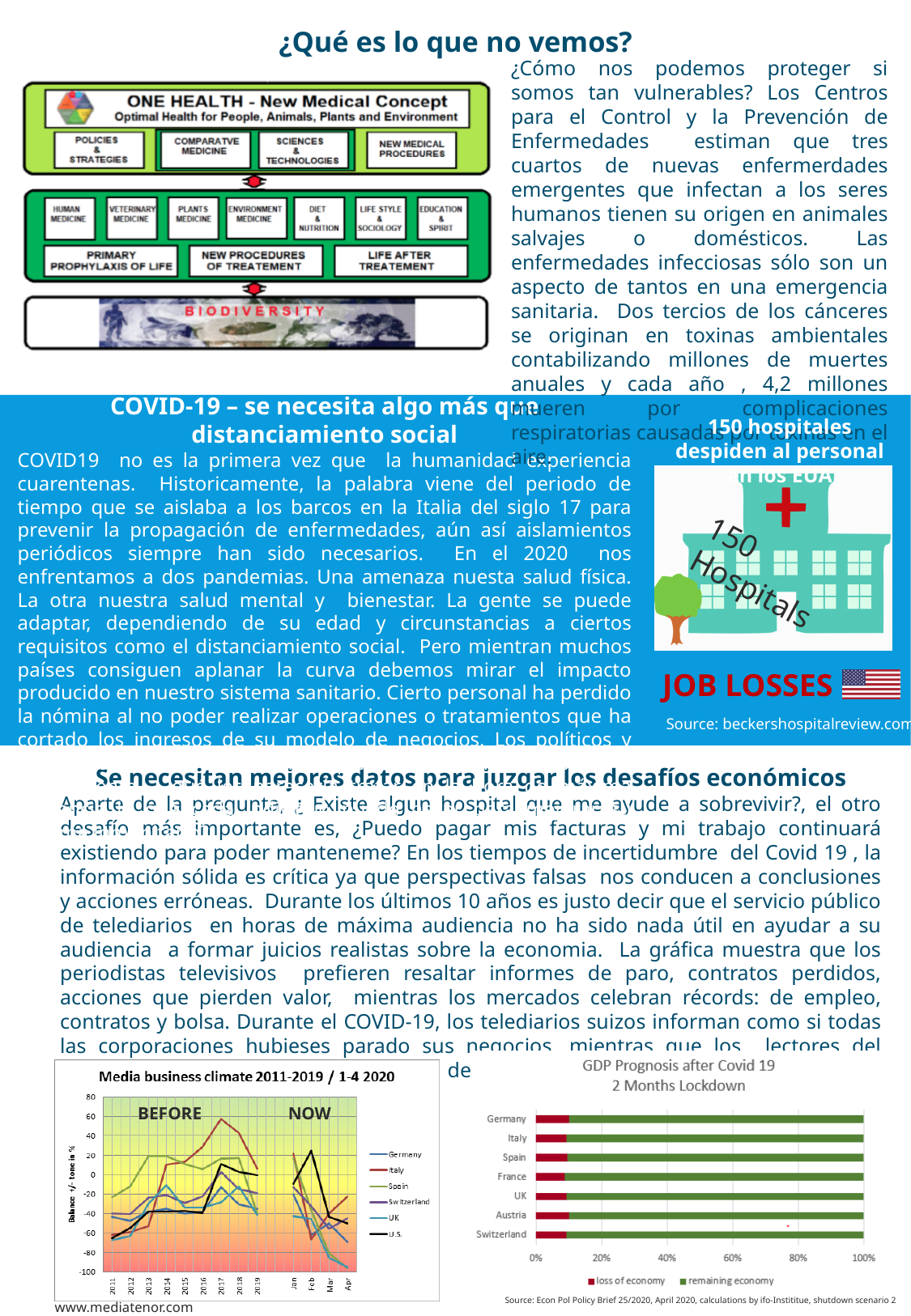
In the 'GDP Prognosis after Covid 19 2 Months Lockdown' chart, is the 'loss of economy' value for Germany greater or less than 20%? less What are the two legend entries of the 'GDP Prognosis after Covid 19 2 Months Lockdown' chart? loss of economy, remaining economy In the 'Media business climate 2011-2019 / 1-4 2020' chart, is the value for UK in Apr greater or less than -60? less How many series does the legend of the 'GDP Prognosis after Covid 19 2 Months Lockdown' chart list? 2 In the 'GDP Prognosis after Covid 19 2 Months Lockdown' chart, is the 'remaining economy' value for Switzerland greater or less than 80%? greater How many countries are shown in the 'GDP Prognosis after Covid 19 2 Months Lockdown' chart? 7 What kind of chart is the 'Media business climate 2011-2019 / 1-4 2020' chart? line chart How many series does the legend of the 'Media business climate 2011-2019 / 1-4 2020' chart list? 6 What kind of chart is the 'GDP Prognosis after Covid 19 2 Months Lockdown' chart? bar chart What is the title of the line chart at the bottom left of the slide? Media business climate 2011-2019 / 1-4 2020